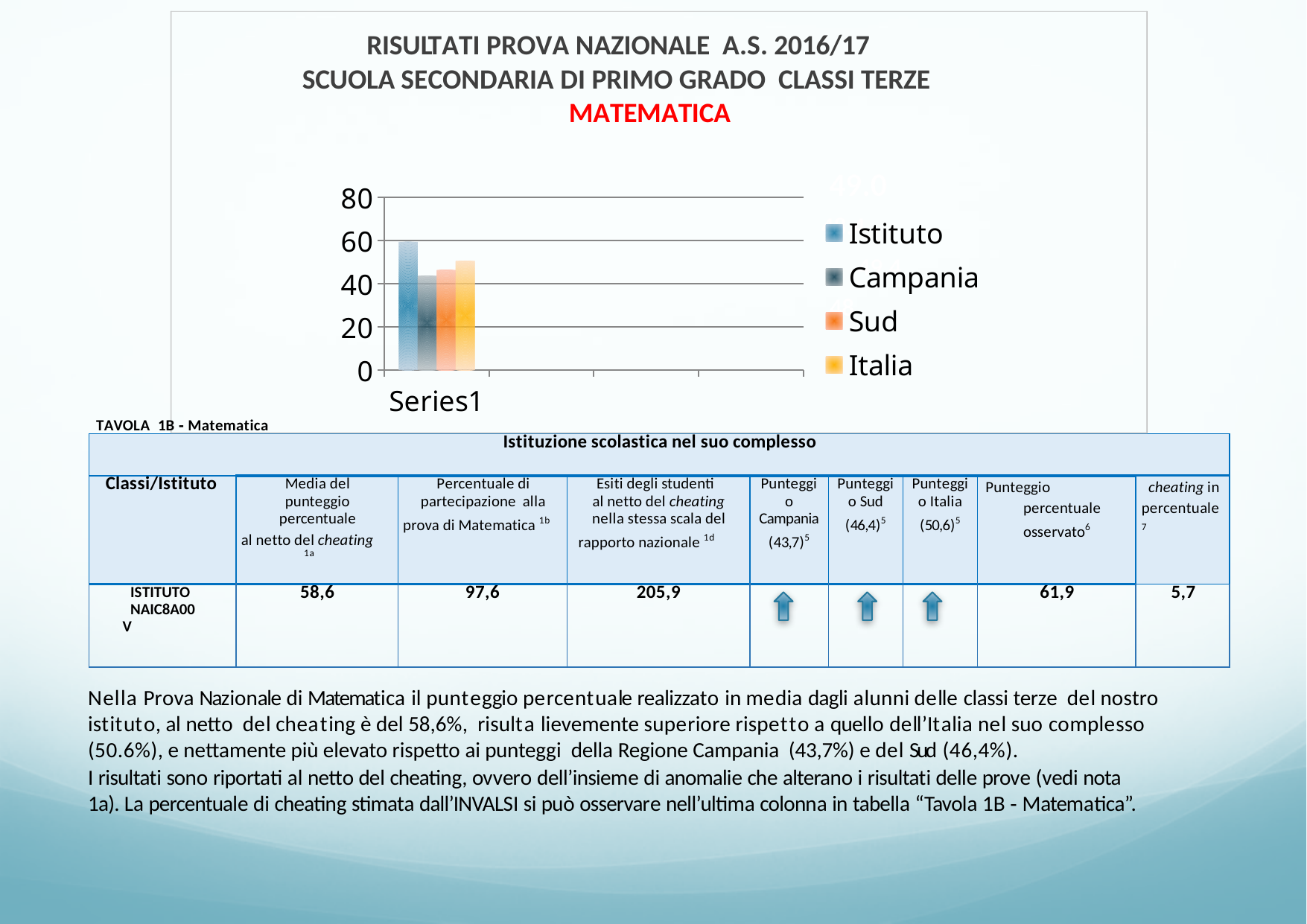
Which series has the highest bar in the chart? Istituto What is the label shown on the x axis of the chart? Series1 Which series is shown in yellow in the chart legend? Italia Is the bar for Sud greater or less than 60? less Is the bar for Italia greater or less than 60? less Which series has the lowest bar in the chart? Campania Which bar is taller, Istituto or Italia? Istituto Is the bar for Istituto greater or less than 40? greater How many series does the chart legend list? 4 Which bar is taller, Sud or Italia? Italia What kind of chart is shown on the slide? bar chart